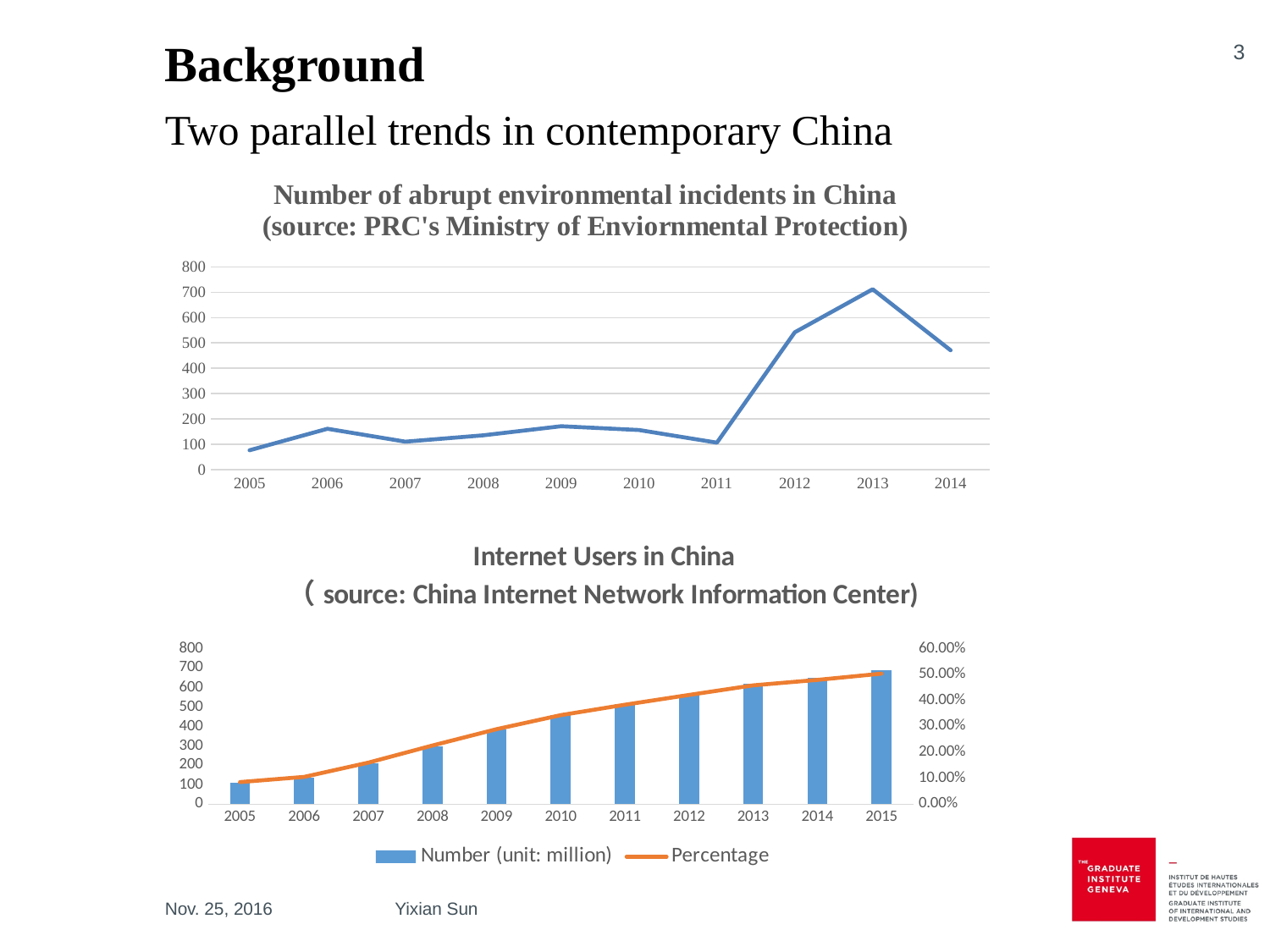
In the top chart, 'Number of abrupt environmental incidents in China', which year has the lowest value? 2005 In the top chart, 'Number of abrupt environmental incidents in China', which is larger, the value for 2012 or the value for 2011? 2012 In the bottom chart, 'Internet Users in China', is the Number (unit: million) bar for 2015 greater or less than 600? greater In the bottom chart, 'Internet Users in China', which year has the tallest bar for Number (unit: million)? 2015 In the top chart, 'Number of abrupt environmental incidents in China', is the value for 2014 greater or less than 500? less What kind of chart is the top chart, 'Number of abrupt environmental incidents in China'? line chart In the bottom chart, 'Internet Users in China', how many series does the legend list? 2 In the top chart, 'Number of abrupt environmental incidents in China', how many years are plotted on the x axis? 10 In the top chart, 'Number of abrupt environmental incidents in China', is the value for 2013 greater or less than 600? greater In the bottom chart, 'Internet Users in China', do the Number (unit: million) bars rise or fall from 2005 to 2015? rise In the top chart, 'Number of abrupt environmental incidents in China', which year has the highest value? 2013 In the bottom chart, 'Internet Users in China', how many years are shown on the x axis? 11